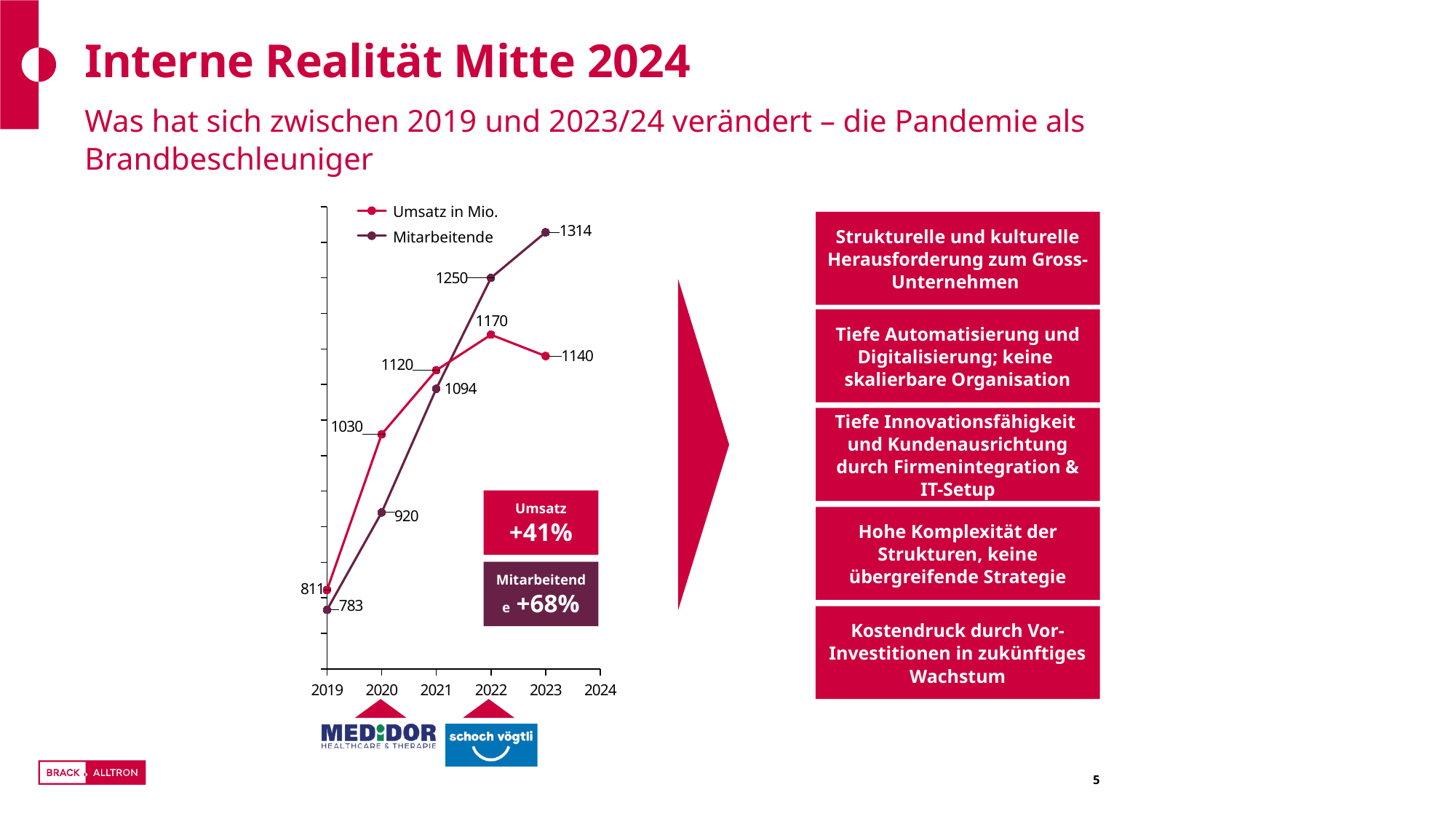
What kind of chart is shown on the slide? line chart In which year is Umsatz in Mio. highest? 2022 What is the value of Mitarbeitende for 2023? 1314 What is the difference between Mitarbeitende in 2023 and in 2019? 531 What is the value of Mitarbeitende for 2021? 1094 What is the value of Umsatz in Mio. for 2022? 1170 What is the value of Umsatz in Mio. for 2019? 811 How many series does the chart legend list? 2 In which year is Mitarbeitende lowest? 2019 Does Mitarbeitende rise or fall from 2019 to 2023? rise Which is larger in 2020: Umsatz in Mio. or Mitarbeitende? Umsatz in Mio. What are the two series named in the chart legend? Umsatz in Mio. and Mitarbeitende